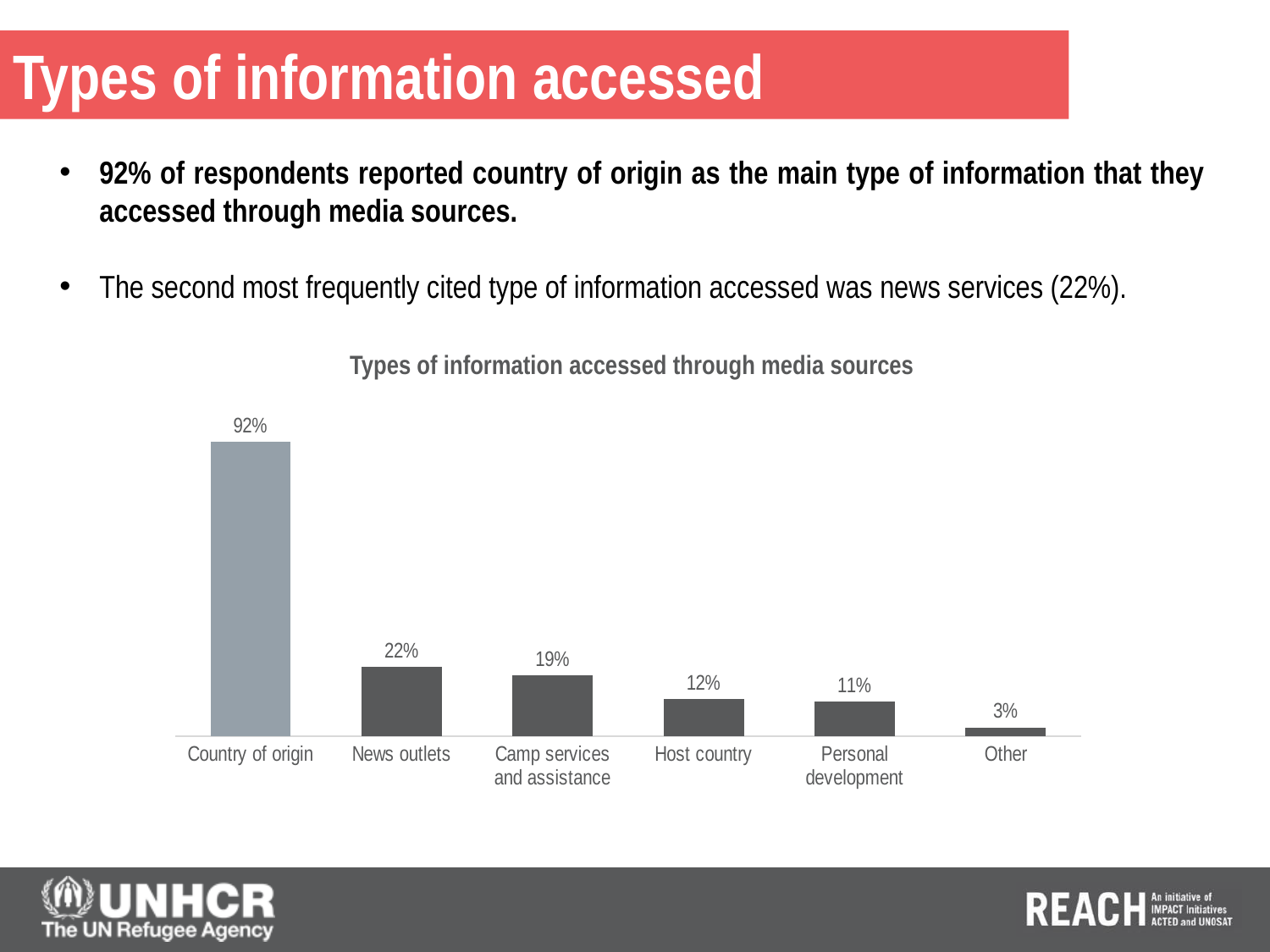
What is the value for Country of origin? 92% Which category has the lowest value? Other What is the title of the chart? Types of information accessed through media sources What is the difference between the values for Country of origin and News outlets? 70% What kind of chart is shown on the slide? Bar chart How many categories are shown in the chart? 6 Which category has the highest value? Country of origin What is the value for Personal development? 11% What is the value for Camp services and assistance? 19% Which is larger, the value for Camp services and assistance or the value for Host country? Camp services and assistance What is the value for News outlets? 22% What is the value for Host country? 12%